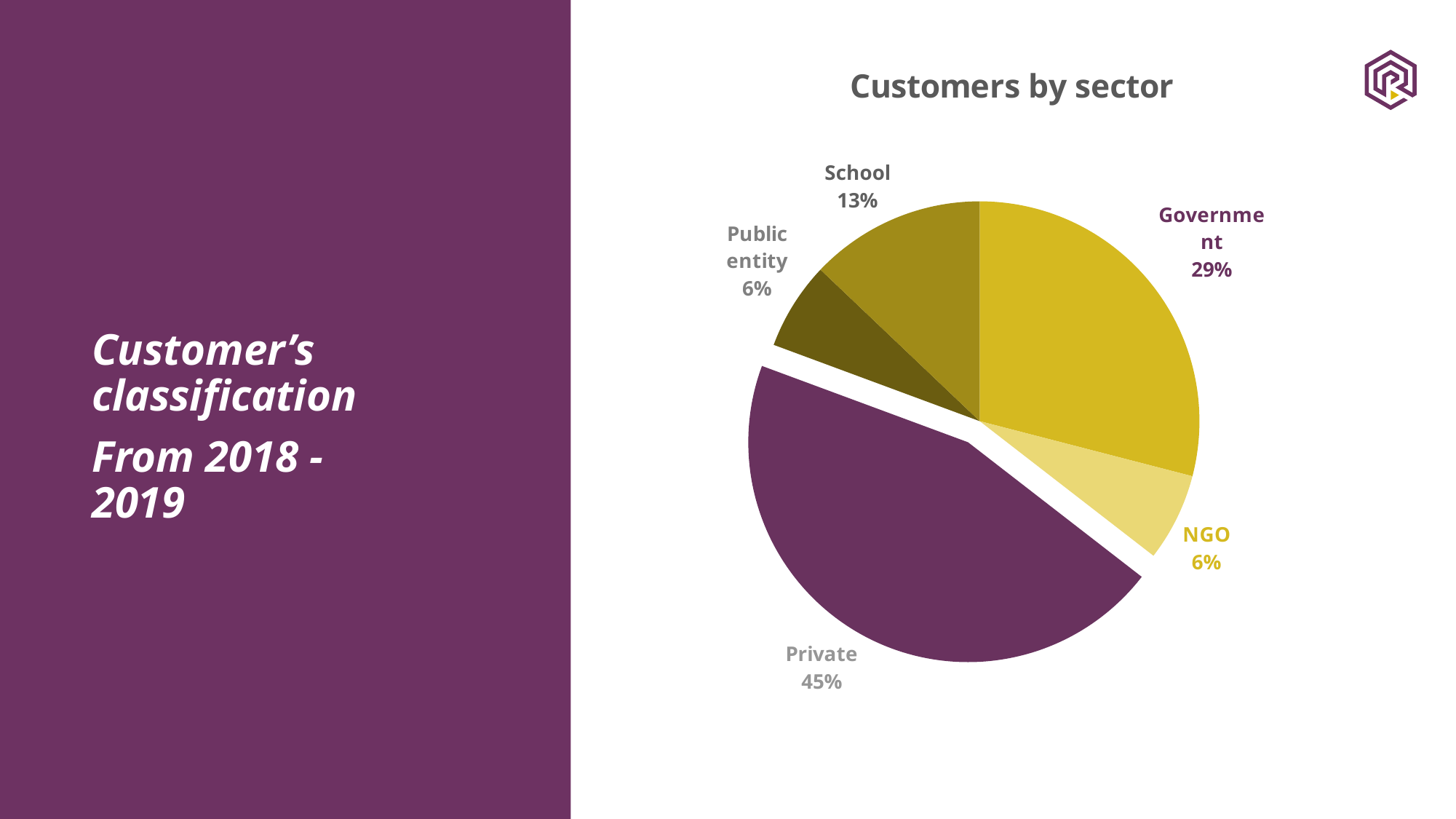
Which slice is pulled out (exploded) from the pie? Private What share of customers is in the NGO sector? 6% Which sector has the largest share of customers? Private What share of customers is in the Government sector? 29% What is the title of the chart? Customers by sector How many sectors are shown in the pie chart? 5 What is the difference between the Private and Government shares? 16% What kind of chart is shown on the slide? Pie chart What share of customers is in the School sector? 13% What share of customers is in the Private sector? 45% What is the difference between the Government and School shares? 16% Which is larger, the School share or the NGO share? School